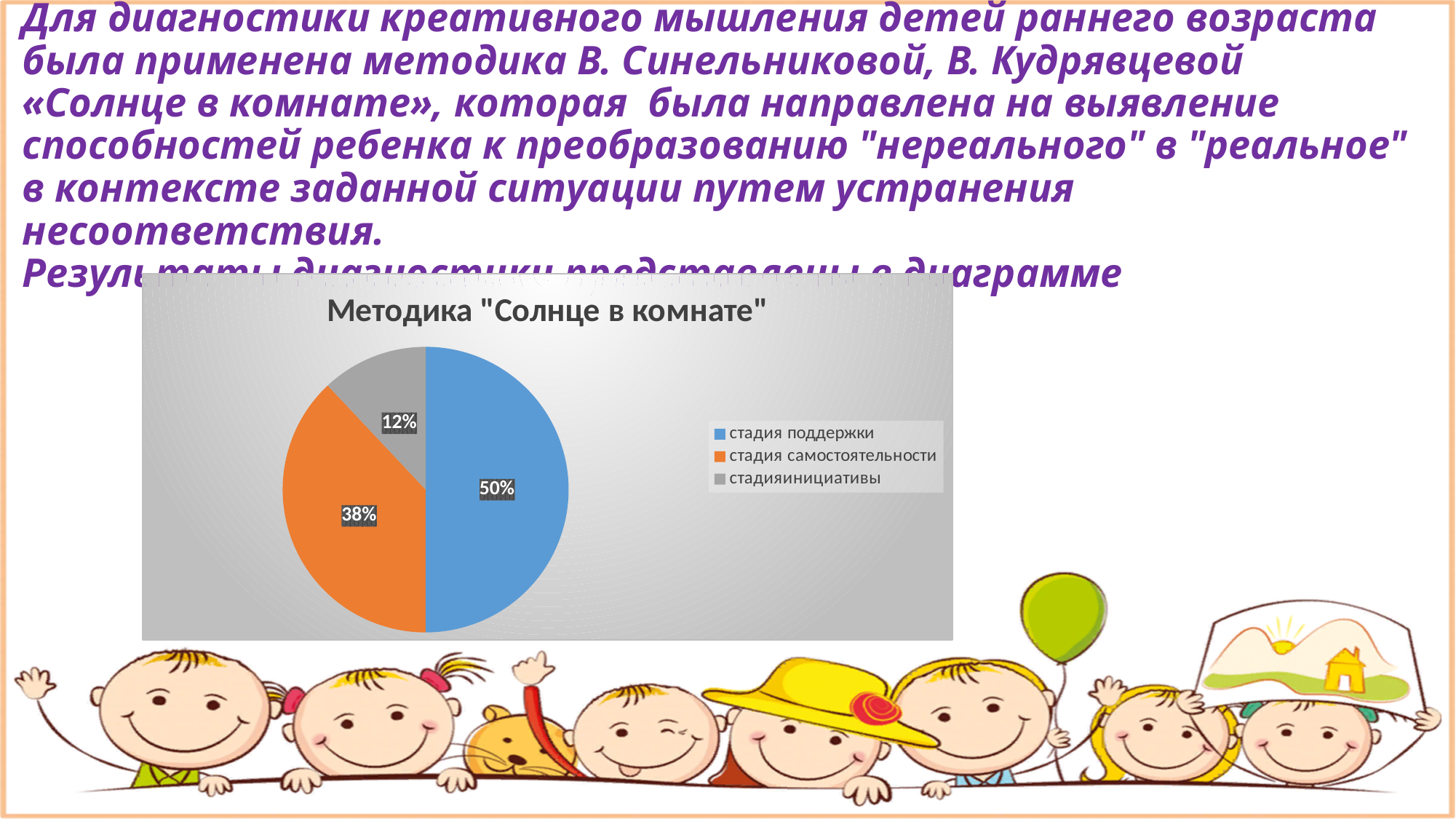
Which category has the largest share of the pie? стадия поддержки What percentage is shown for "стадия поддержки"? 50% How many slices does the pie chart have? 3 What type of chart is shown on the slide? pie chart What percentage is shown for "стадия самостоятельности"? 38% How many categories does the legend list? 3 What colour is the slice for "стадия самостоятельности"? orange What is the title of the chart? Методика "Солнце в комнате" Which category has the smallest share of the pie? стадияинициативы What percentage is shown for "стадияинициативы"? 12% What is the difference between the shares of "стадия поддержки" and "стадия самостоятельности"? 12% Which is larger: the share of "стадия самостоятельности" or "стадияинициативы"? стадия самостоятельности